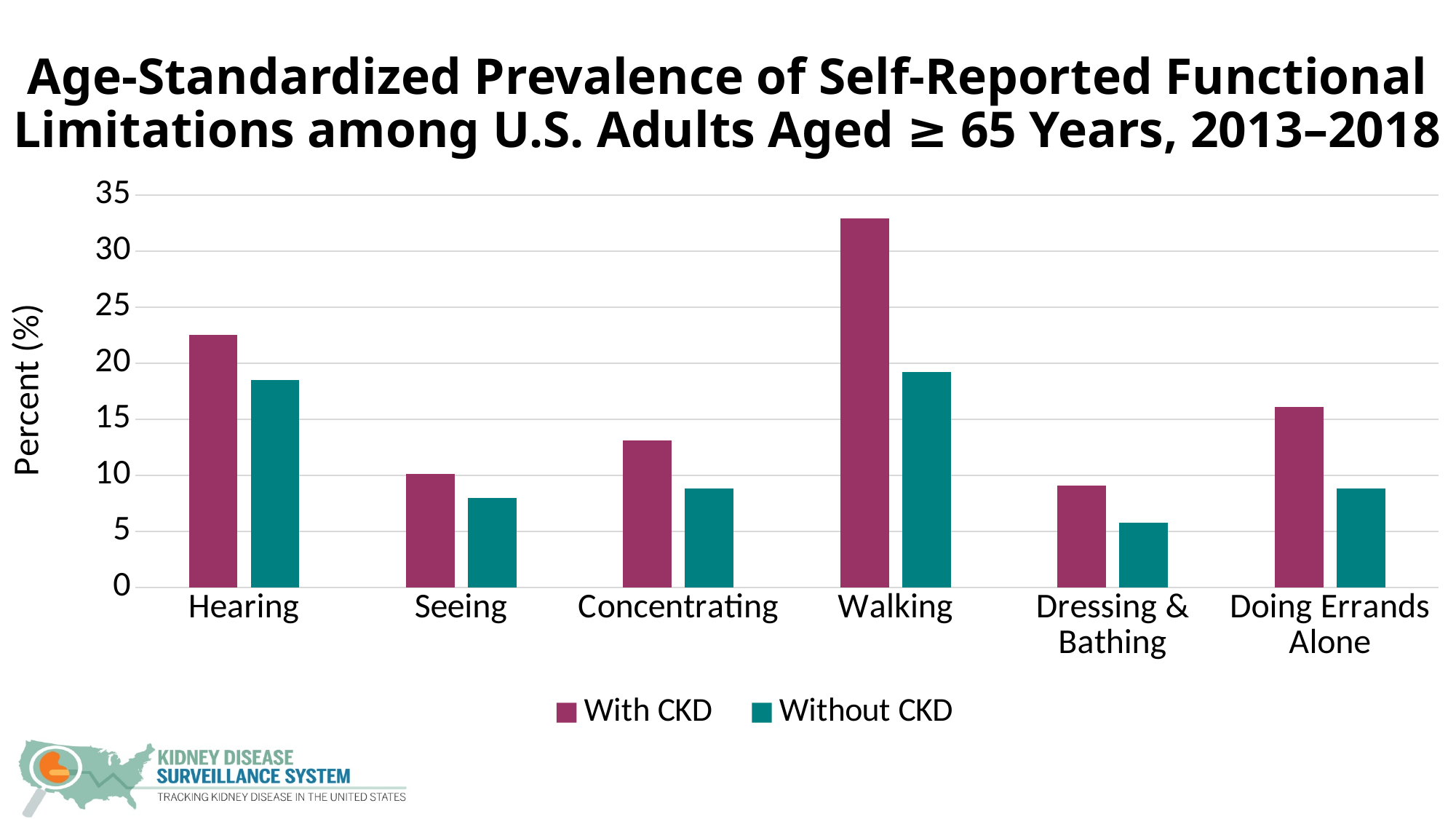
Which category has the lowest value for With CKD? Dressing & Bathing Is the Without CKD value for Seeing greater or less than 10? less What kind of chart is shown on the slide? bar chart Which category has the lowest value for Without CKD? Dressing & Bathing For Hearing, which is larger: the With CKD value or the Without CKD value? With CKD Which category has the highest value for With CKD? Walking How many series does the legend list? 2 What is the label of the y axis? Percent (%) Is the Without CKD value for Hearing greater or less than 20? less How many functional limitation categories are shown on the x axis? 6 Is the With CKD value for Walking greater or less than 30? greater